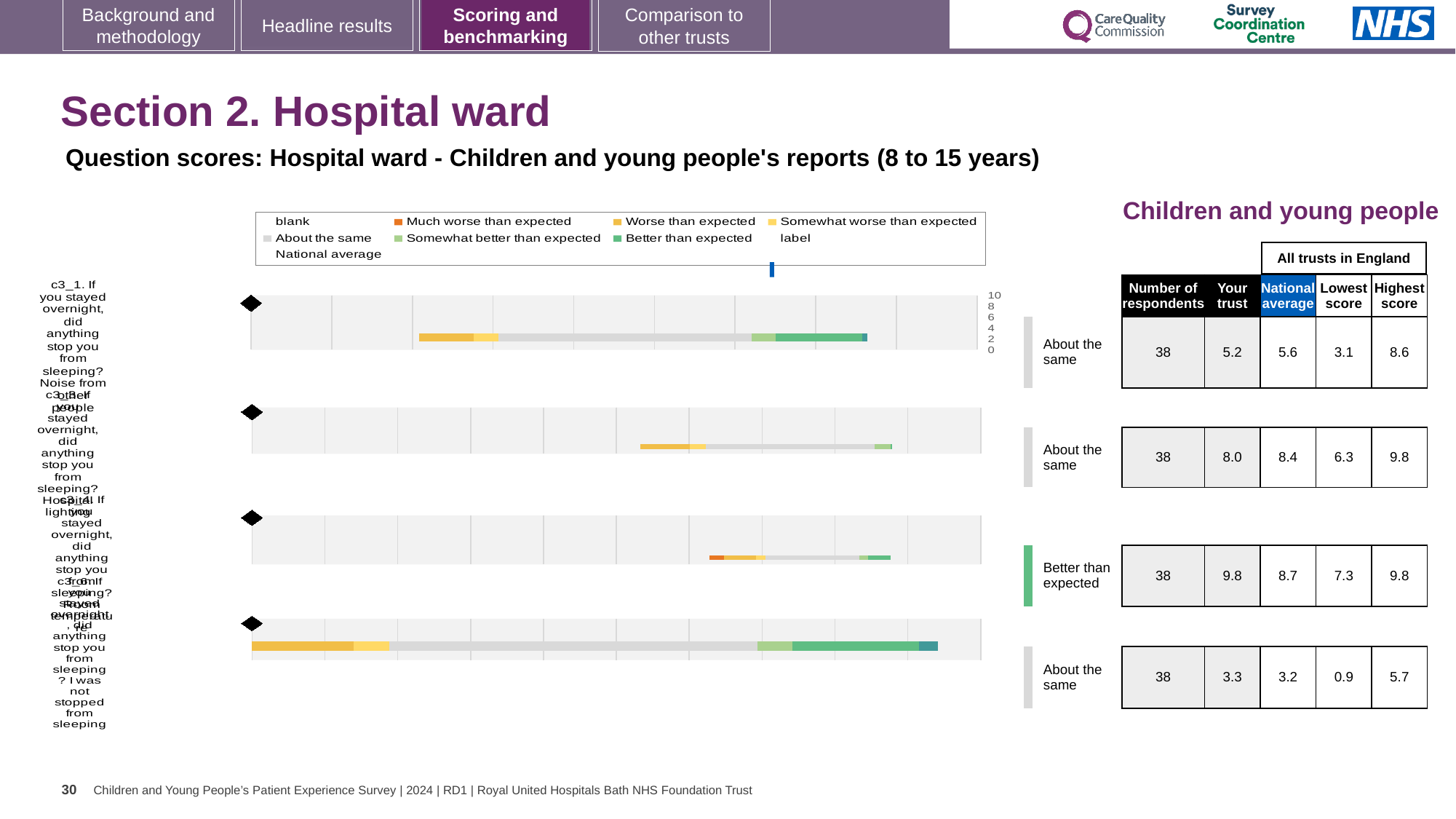
What kind of chart is used to show the question scores on this slide? bar chart What colour does the legend use for "Better than expected"? green Which benchmark label is given to the third bar from the top? Better than expected In the table beside the chart, what is the difference between the "Your trust" score and the National average in the third row (9.8 vs 8.7)? 1.1 In the table beside the chart, how many respondents are listed for the first row? 38 In the table beside the chart, which row has the lowest "Your trust" score? the fourth row (3.3) How many horizontal bars are plotted in the chart? 4 What is the highest tick value shown on the chart's score axis? 10 In the table beside the chart, what is the Highest score for the second row? 9.8 In the table beside the chart, what is the "Your trust" score for the third row (Better than expected)? 9.8 In the table beside the chart, for the first row, which is larger: the "Your trust" score or the National average? National average How many entries does the chart legend list? 9